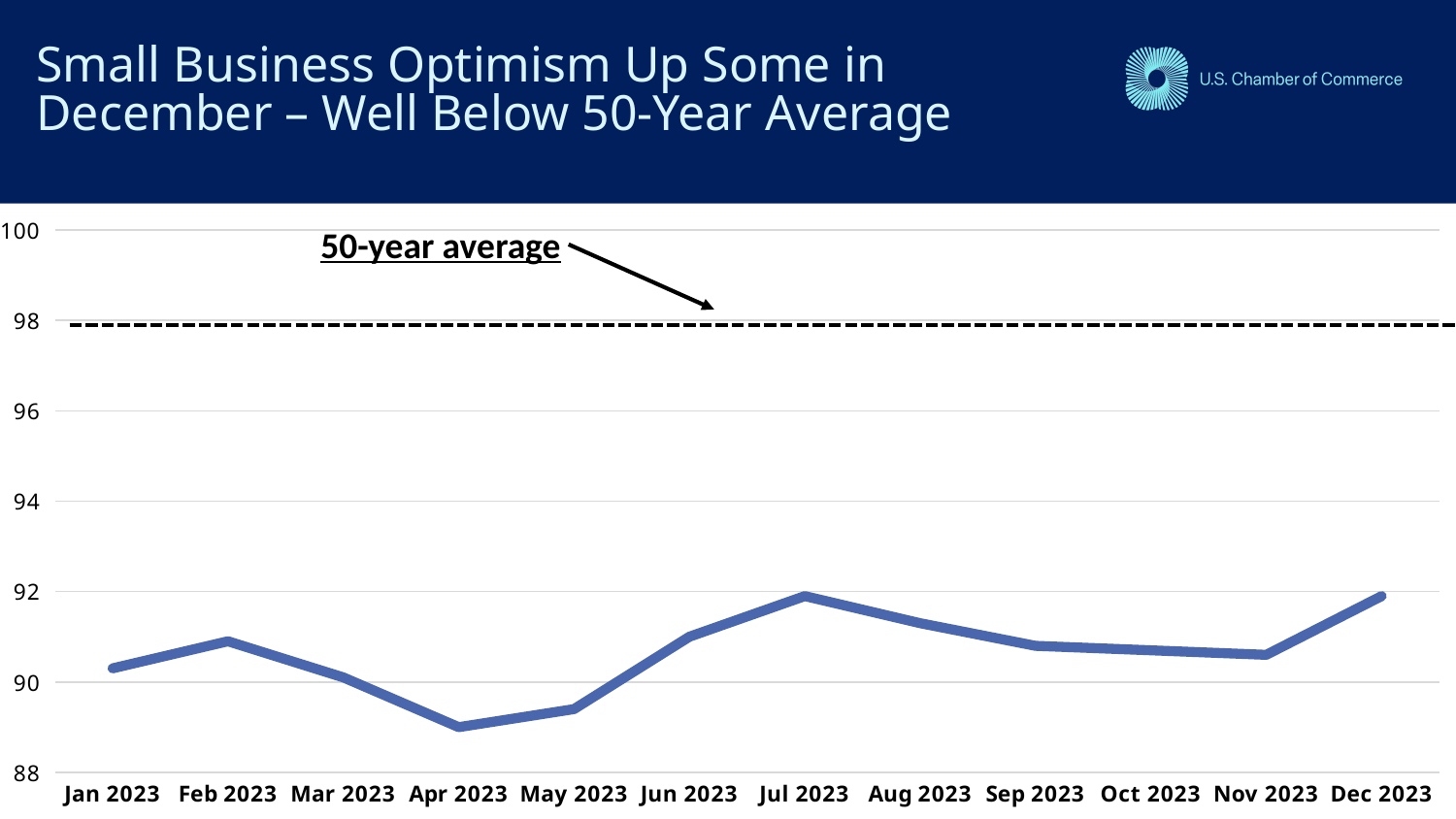
What does the dashed horizontal line on the chart represent? 50-year average Which is larger, the value for Feb 2023 or the value for Mar 2023? Feb 2023 Is the value for Dec 2023 greater or less than 94? less Which month has the lowest value on the chart? Apr 2023 Which is larger, the value for Jun 2023 or the value for May 2023? Jun 2023 Is the value for May 2023 greater or less than 90? less Is the value for Apr 2023 greater or less than 90? less Do the values rise or fall from Apr 2023 to Jul 2023? rise What kind of chart is shown on the slide? line chart How many months are plotted along the x axis? 12 Do the values rise or fall from Jan 2023 to Apr 2023? fall